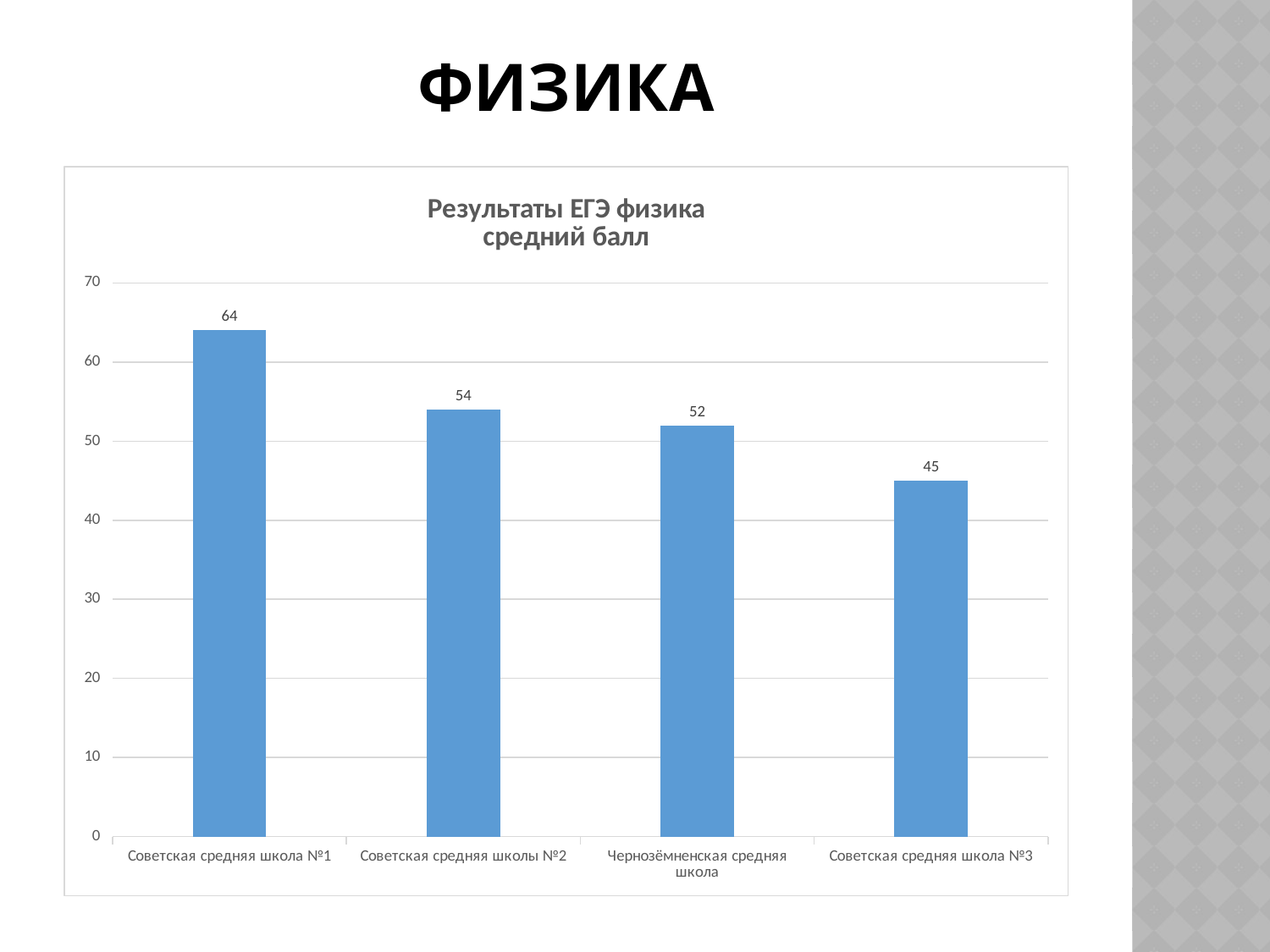
Which school has the highest average physics EGE score? Советская средняя школа №1 What is the value shown for Советская средняя школа №3? 45 What is the title of the chart? Результаты ЕГЭ физика средний балл What is the difference between the scores of Советская средняя школа №1 and Советская средняя школа №3? 19 Which school has the lowest average physics EGE score? Советская средняя школа №3 What kind of chart is shown on the slide? bar chart What is the average physics EGE score for Советская средняя школа №1? 64 What is the difference between the scores of Советская средняя школы №2 and Чернозёмненская средняя школа? 2 Which has a higher score: Советская средняя школы №2 or Советская средняя школа №3? Советская средняя школы №2 Is the value for Чернозёмненская средняя школа greater or less than 60? less What is the average physics EGE score for Чернозёмненская средняя школа? 52 How many schools are shown on the chart? 4